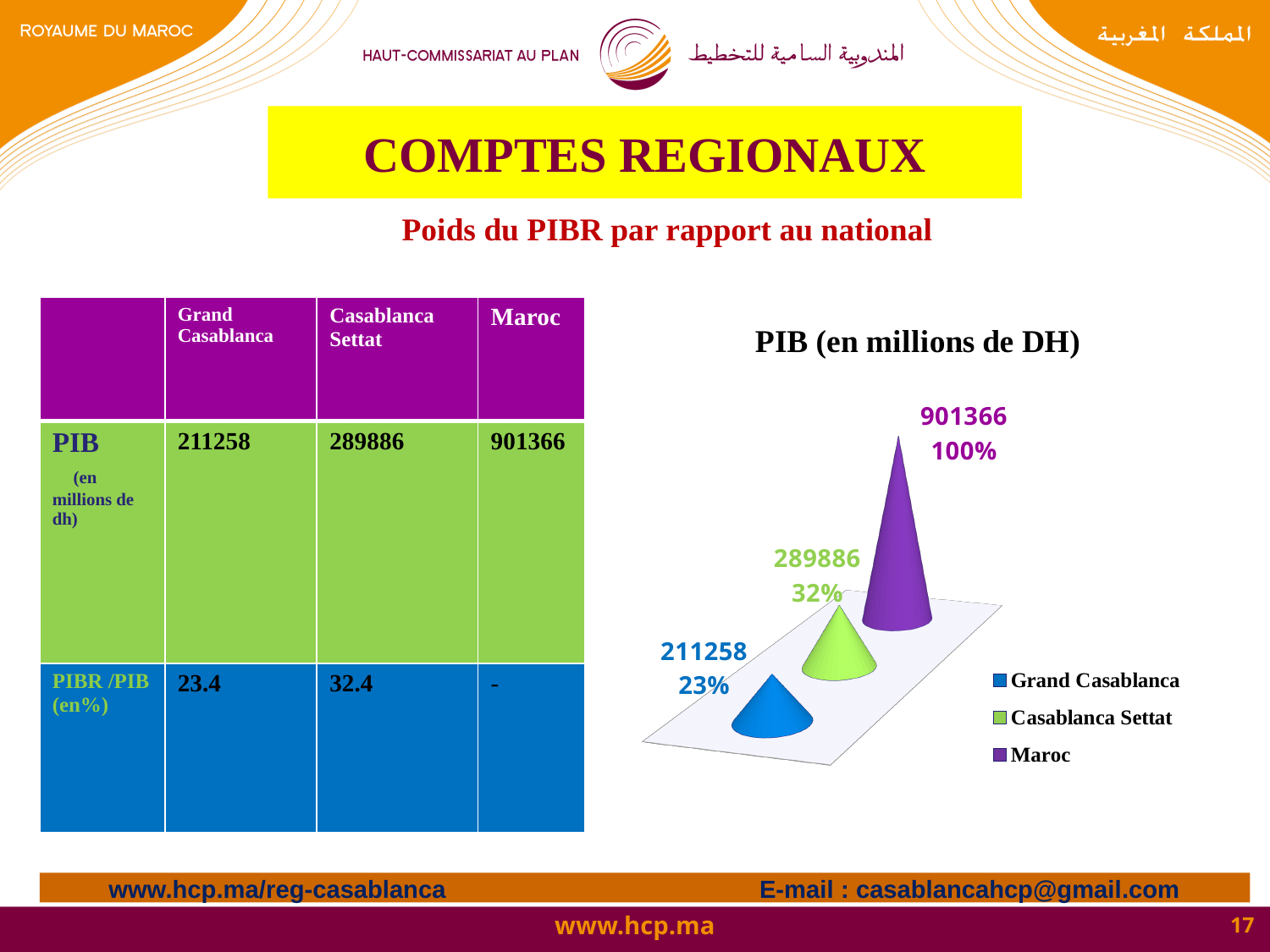
What is the value shown for Maroc in the chart? 901366 Which category has the lowest value in the chart? Grand Casablanca Which category has the highest value in the chart? Maroc How many entries does the chart legend list? 3 What is the value shown for Casablanca Settat in the chart? 289886 What is the value shown for Grand Casablanca in the chart? 211258 What is the difference between the values for Casablanca Settat and Grand Casablanca in the chart? 78628 How many categories are plotted in the chart? 3 Which is larger in the chart, the value for Casablanca Settat or the value for Grand Casablanca? Casablanca Settat What percentage label is shown next to Grand Casablanca in the chart? 23% What is the title of the chart? PIB (en millions de DH) What percentage label is shown next to Casablanca Settat in the chart? 32%